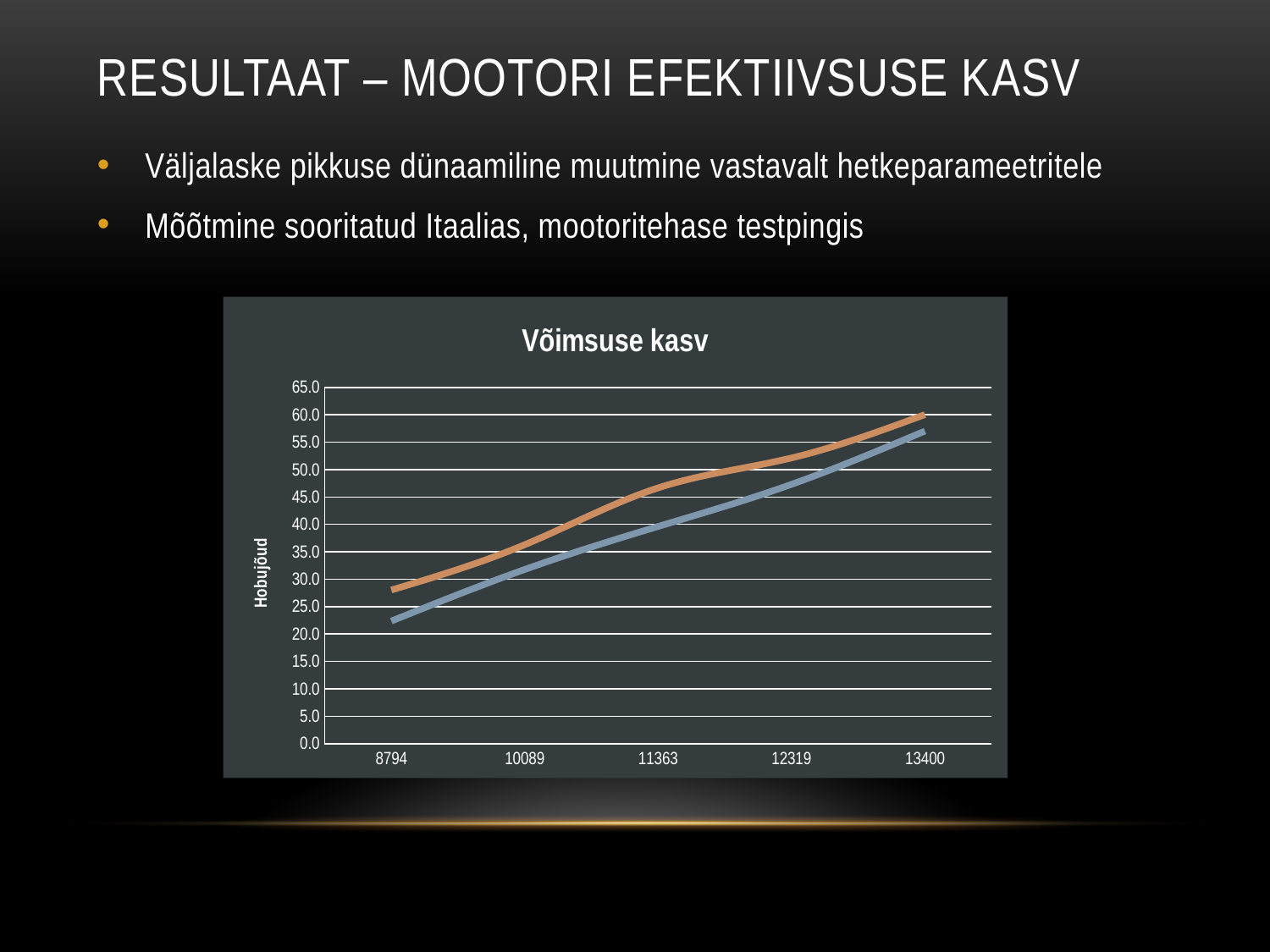
What is the title of the chart? Võimsuse kasv At 11363, which line has the larger value, the orange line or the blue line? orange line Is the value of the orange line at 13400 greater or less than 55.0? greater Is the value of the blue line at 8794 greater or less than 25.0? less What kind of chart is shown on the slide? line chart How many categories are shown along the x axis of the chart? 5 Do the values of the blue line rise or fall as you move from 8794 to 13400 along the x axis? rise Do the values of the orange line rise or fall as you move from 8794 to 13400 along the x axis? rise At which x-axis category does the orange line reach its highest value? 13400 Is the value of the orange line at 11363 greater or less than 45.0? greater What is the label on the vertical axis of the chart? Hobujõud At 8794, which line has the larger value, the orange line or the blue line? orange line